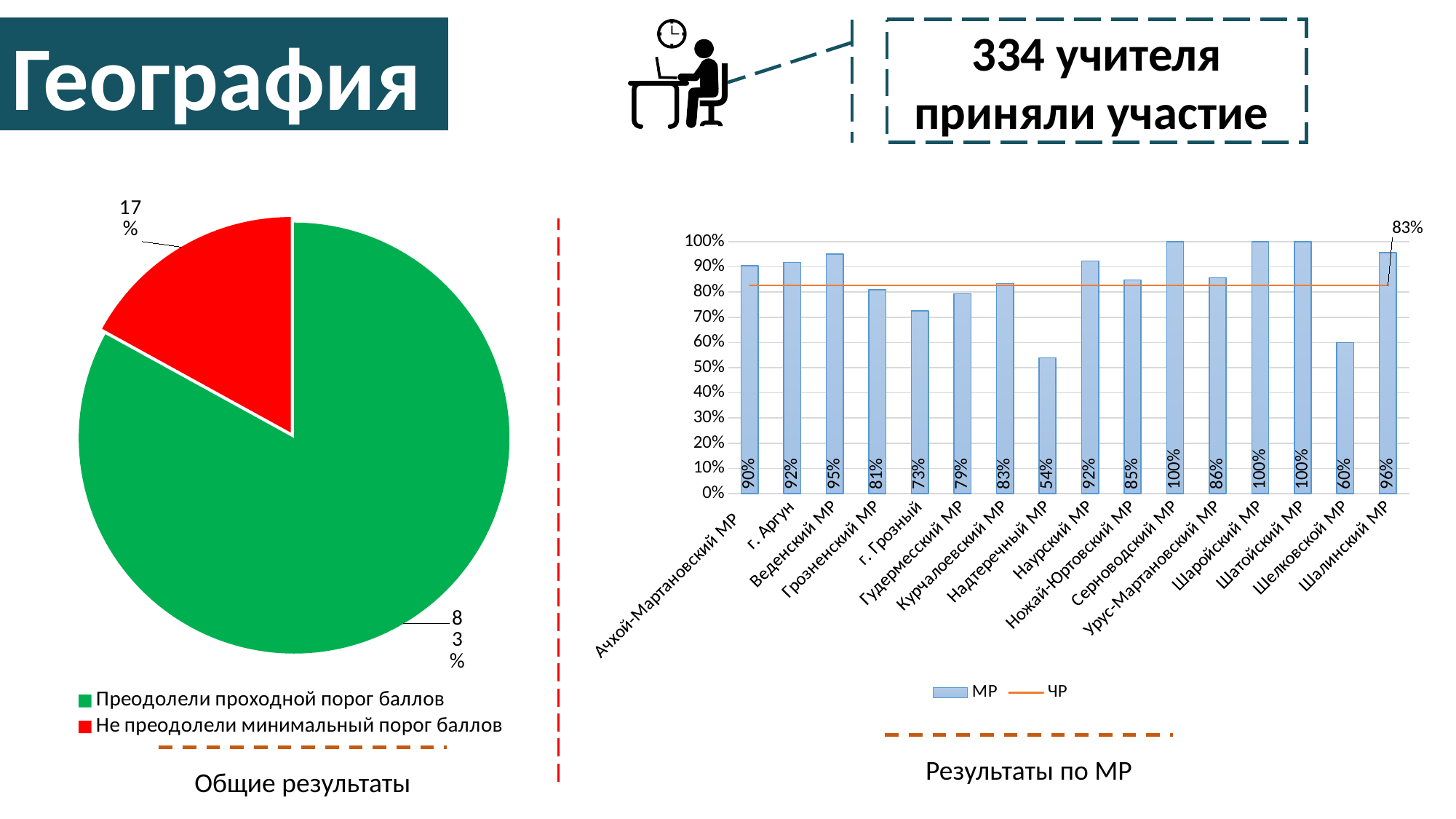
In the bar chart on the right, which category has the lowest value? Надтеречный МР In the pie chart on the left, how many slices does the pie have? 2 In the bar chart on the right, which is larger, the value for Шелковской МР or the value for Шалинский МР? Шалинский МР In the bar chart on the right, what is the value for Надтеречный МР? 54% In the bar chart on the right, what is the value for г. Грозный? 73% In the pie chart on the left, what share of the pie is labelled 'Не преодолели минимальный порог баллов'? 17% In the bar chart on the right, what is the difference between the values for Веденский МР and Грозненский МР? 14% In the bar chart on the right, how many categories are shown on the x axis? 16 What kind of chart is shown on the right side of the slide under 'Результаты по МР'? combination bar and line chart In the bar chart on the right, how many series does the legend list? 2 In the bar chart on the right, what value is labelled on the ЧР line? 83% In the pie chart on the left, what share of the pie is labelled 'Преодолели проходной порог баллов'? 83%